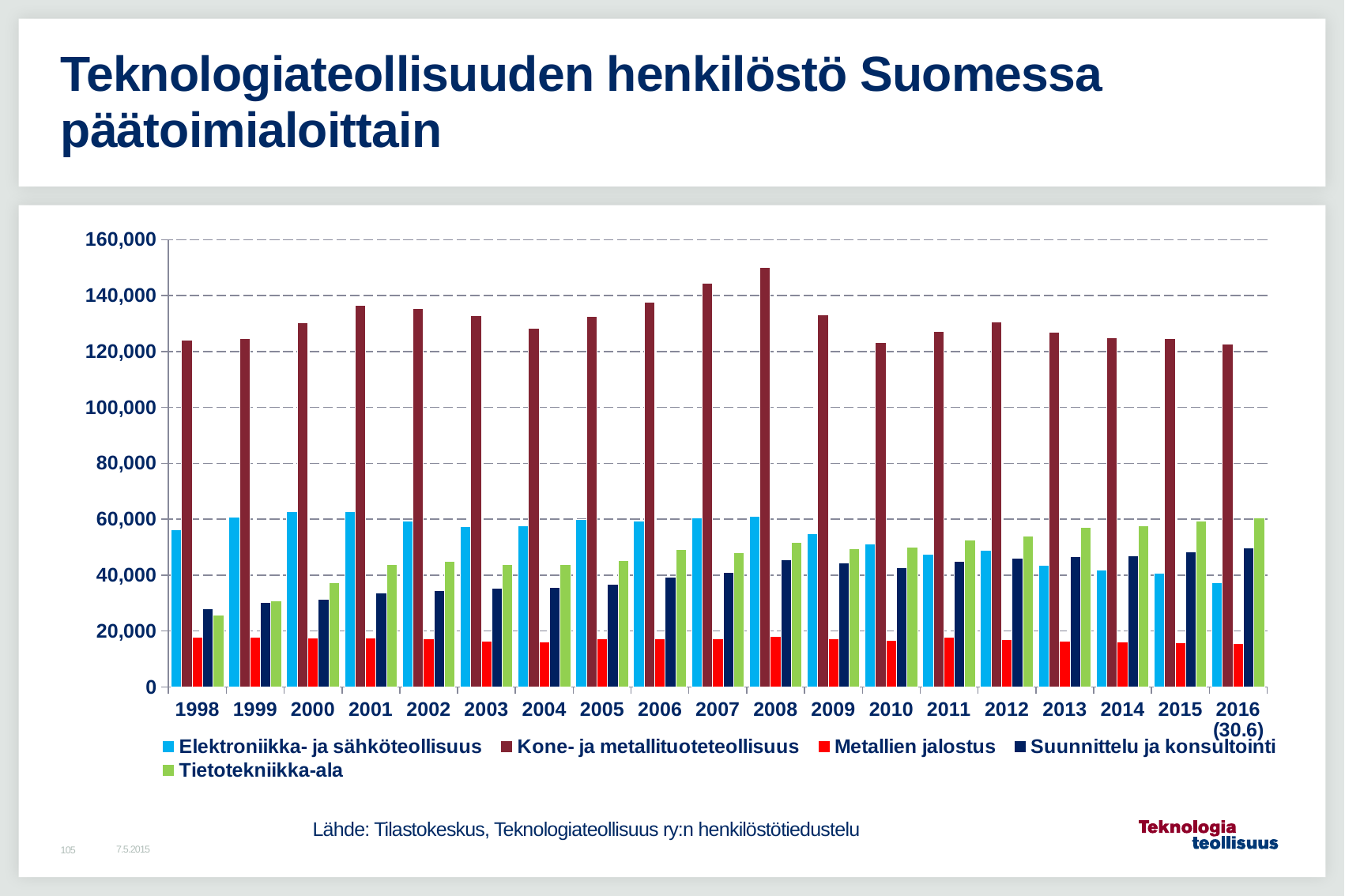
What kind of chart is shown on the slide? bar chart In which year is the value for Tietotekniikka-ala lowest? 1998 Is the value for Metallien jalostus in 1998 greater or less than 20,000? less How many series does the legend list? 5 In which year is the value for Kone- ja metallituoteteollisuus highest? 2008 Is the value for Kone- ja metallituoteteollisuus in 2008 greater or less than 140,000? greater Is the value for Elektroniikka- ja sähköteollisuus in 2016 (30.6) greater or less than 40,000? less Which series is shown in red in the legend? Metallien jalostus Does the value for Tietotekniikka-ala generally rise or fall from 1998 to 2016? rise In 2016 (30.6), which is larger: Tietotekniikka-ala or Elektroniikka- ja sähköteollisuus? Tietotekniikka-ala How many years are shown on the x axis? 19